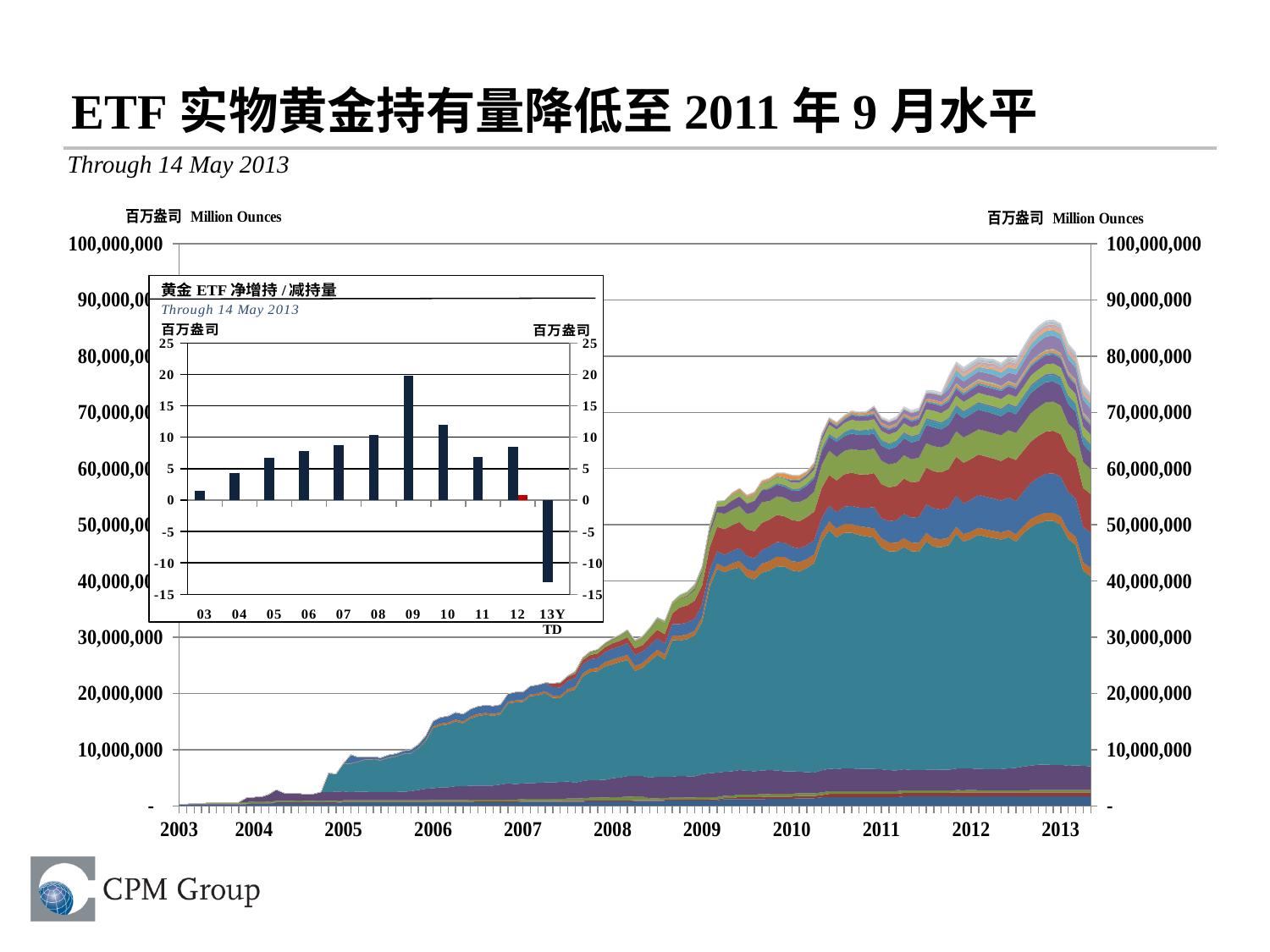
In the inset bar chart 黄金 ETF 净增持/减持量, is the value for 09 greater or less than 15? greater In the inset bar chart 黄金 ETF 净增持/减持量, which period has the lowest bar? 13YTD In the large stacked area chart, is the total holdings at the start of 2003 greater or less than 10,000,000? less What unit is shown on the axis labels of the large stacked area chart? Million Ounces In the inset bar chart 黄金 ETF 净增持/减持量, is the value for 13YTD greater or less than -10? less In the inset bar chart 黄金 ETF 净增持/减持量, which is larger, the bar for 09 or the bar for 10? 09 In the inset bar chart 黄金 ETF 净增持/减持量, which is larger, the bar for 08 or the bar for 04? 08 In the inset bar chart 黄金 ETF 净增持/减持量, which year has the highest bar? 09 What kind of chart is the inset chart titled 黄金 ETF 净增持/减持量? bar chart What kind of chart is the large chart in the background showing holdings from 2003 to 2013? stacked area chart